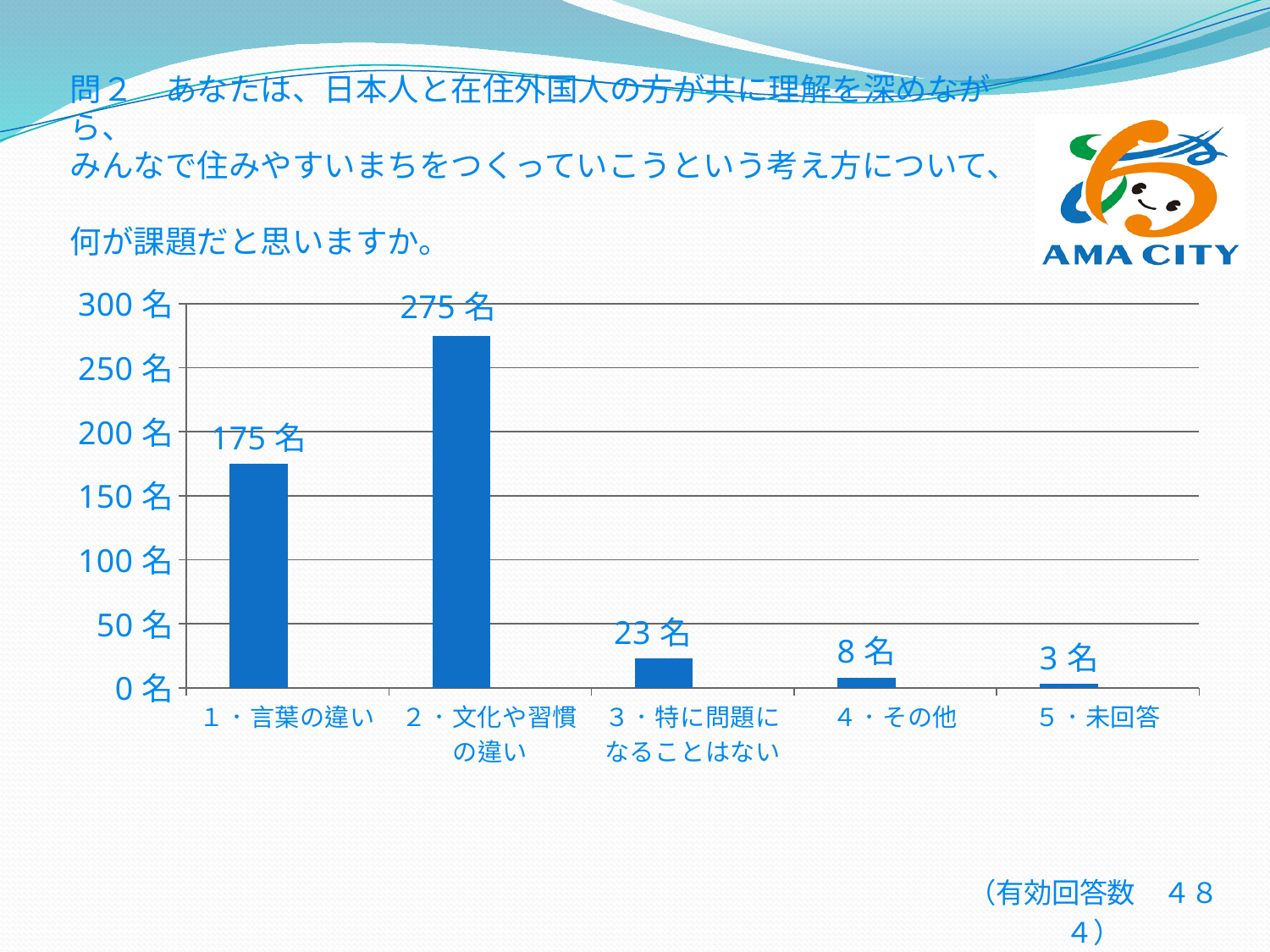
Which category has the lowest value? 5・未回答 What is the difference between the values for 3・特に問題になることはない and 4・その他? 15 名 What is the difference between the values for 2・文化や習慣の違い and 1・言葉の違い? 100 名 What is the value for 5・未回答? 3 名 What is the value for 1・言葉の違い? 175 名 Which category has the highest value? 2・文化や習慣の違い Is the value for 1・言葉の違い greater or less than 150 名? greater What is the value for 2・文化や習慣の違い? 275 名 How many categories are shown on the x axis? 5 What kind of chart is shown on the slide? bar chart What is the value for 3・特に問題になることはない? 23 名 Which is larger, the value for 1・言葉の違い or the value for 3・特に問題になることはない? 1・言葉の違い